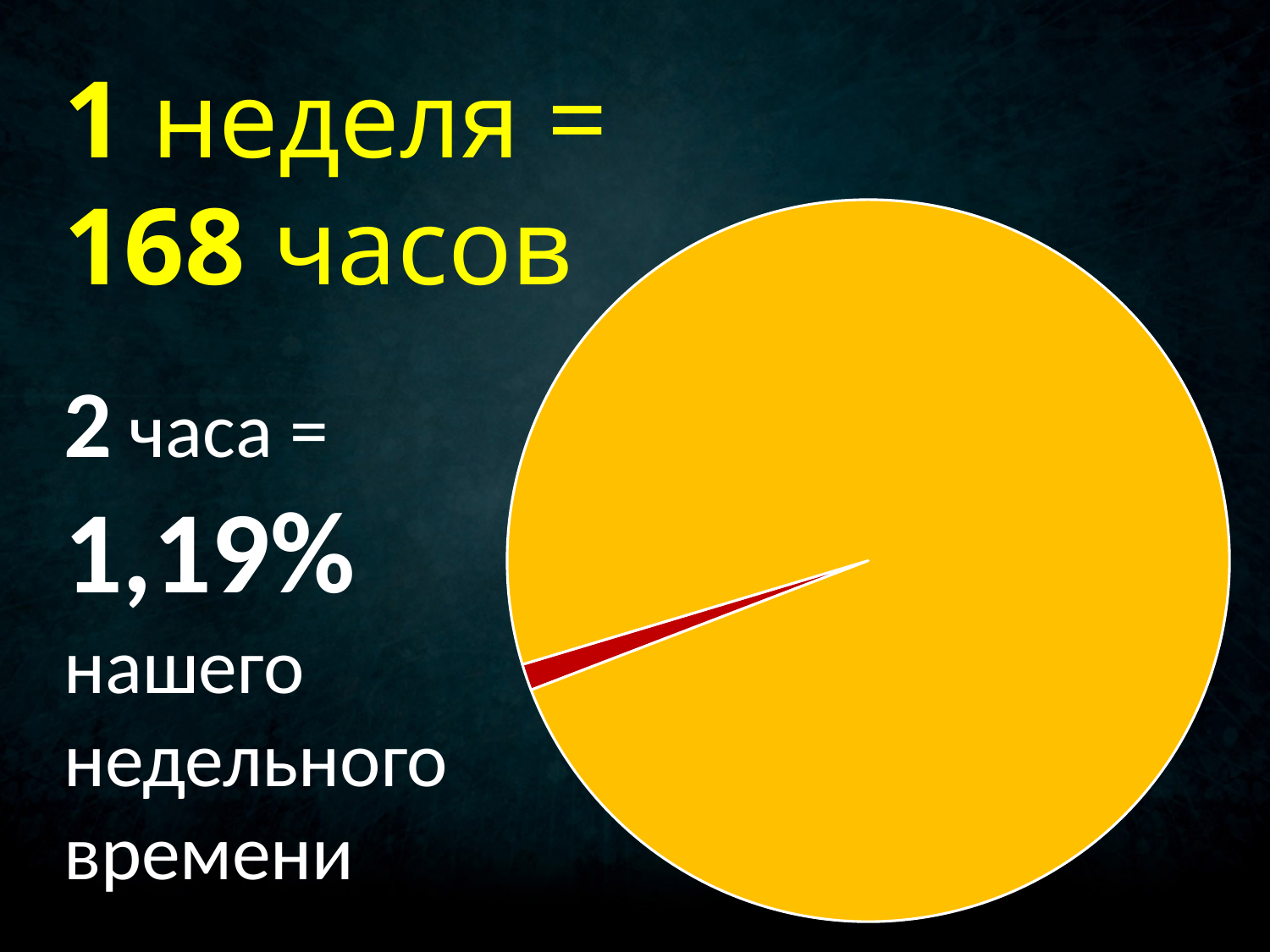
Which slice of the pie chart is the smallest? the red slice According to the slide, what share of the weekly time does the small red slice (2 часа) represent? 1,19% Is the share of the yellow slice greater or less than 50%? greater Which slice of the pie chart is the largest? the yellow slice What kind of chart is shown on the slide? pie chart How many slices does the pie chart have? 2 According to the slide text, how many hours are in 1 week? 168 часов What colour is the large slice of the pie chart? yellow Is the share of the red slice greater or less than 10%? less Which slice of the pie chart is larger, the yellow one or the red one? the yellow one